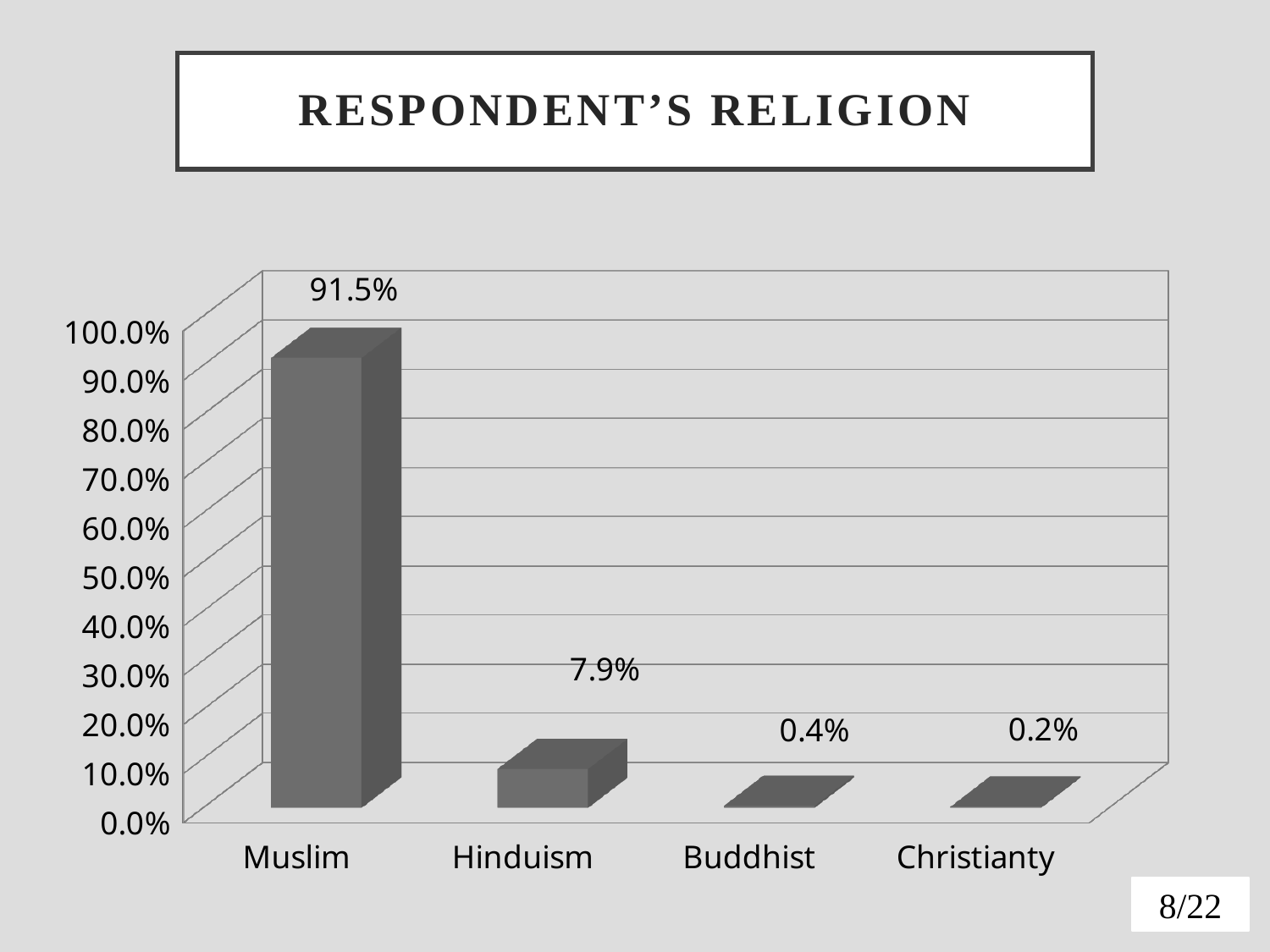
What percentage of respondents are Muslim? 91.5% What percentage of respondents follow Hinduism? 7.9% Which religion has the highest share of respondents? Muslim Which religion has the lowest share of respondents? Christianty What percentage of respondents are listed under Christianty? 0.2% Which is larger, the share for Hinduism or the share for Buddhist? Hinduism Is the value for Muslim greater or less than 90.0%? greater How many religion categories are shown on the chart? 4 What is the title of the slide? RESPONDENT'S RELIGION What kind of chart is shown on the slide? Bar chart What percentage of respondents are Buddhist? 0.4% What is the difference in percentage points between Muslim and Hinduism respondents? 83.6